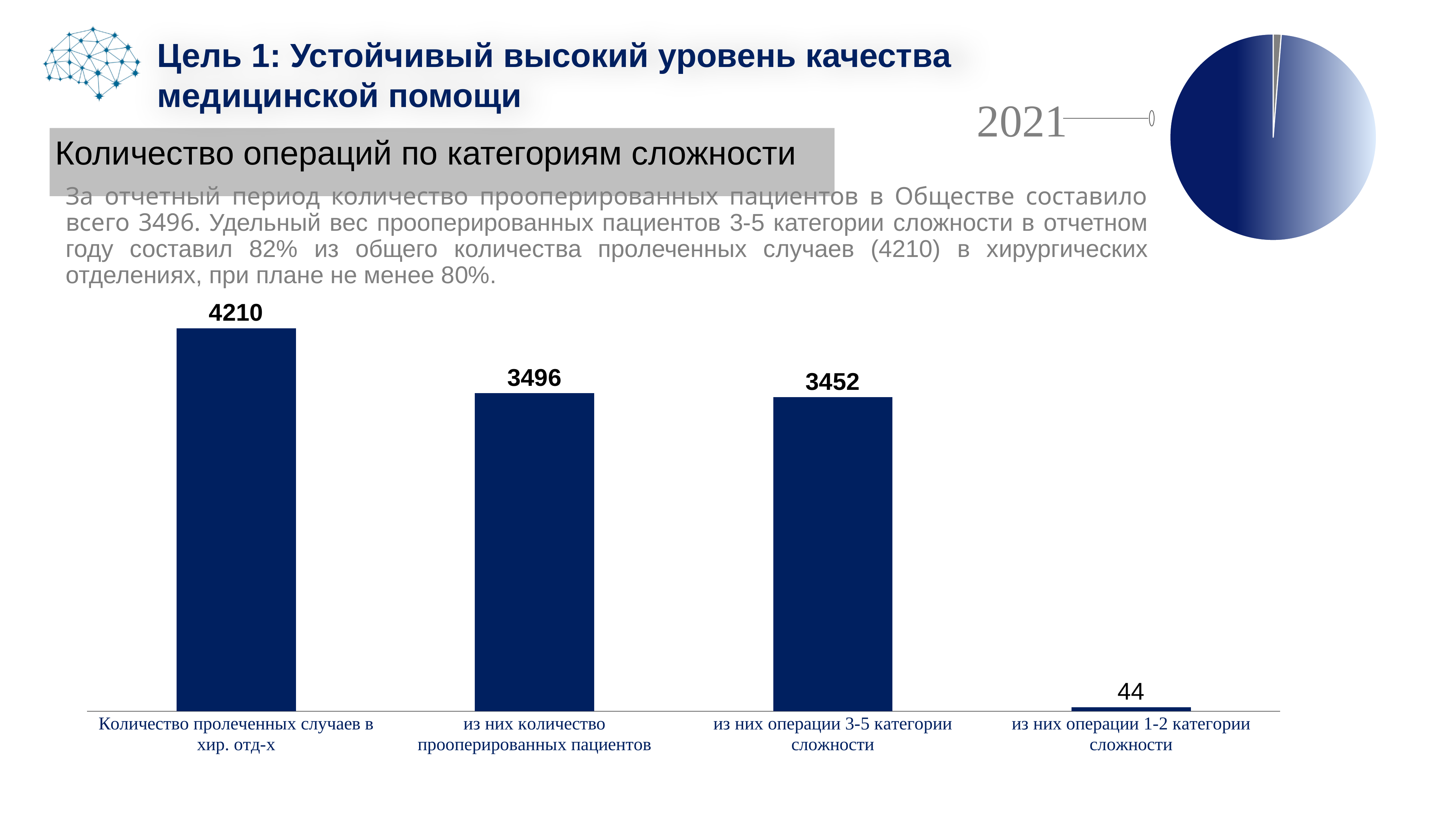
What kind of chart is the large chart at the bottom of the slide? Bar chart On the bar chart, what is the value for "Количество пролеченных случаев в хир. отд-х"? 4210 What is the title shown above the bar chart? Количество операций по категориям сложности On the bar chart, what is the value for "из них операции 1-2 категории сложности"? 44 On the bar chart, what is the difference between "Количество пролеченных случаев в хир. отд-х" and "из них количество прооперированных пациентов"? 714 On the bar chart, what is the value for "из них количество прооперированных пациентов"? 3496 On the bar chart, what is the difference between "из них количество прооперированных пациентов" and "из них операции 3-5 категории сложности"? 44 On the bar chart, which category has the highest value? Количество пролеченных случаев в хир. отд-х How many categories are shown on the bar chart? 4 On the bar chart, which category has the lowest value? из них операции 1-2 категории сложности On the bar chart, which is larger: "из них операции 3-5 категории сложности" or "из них операции 1-2 категории сложности"? из них операции 3-5 категории сложности On the bar chart, what is the value for "из них операции 3-5 категории сложности"? 3452